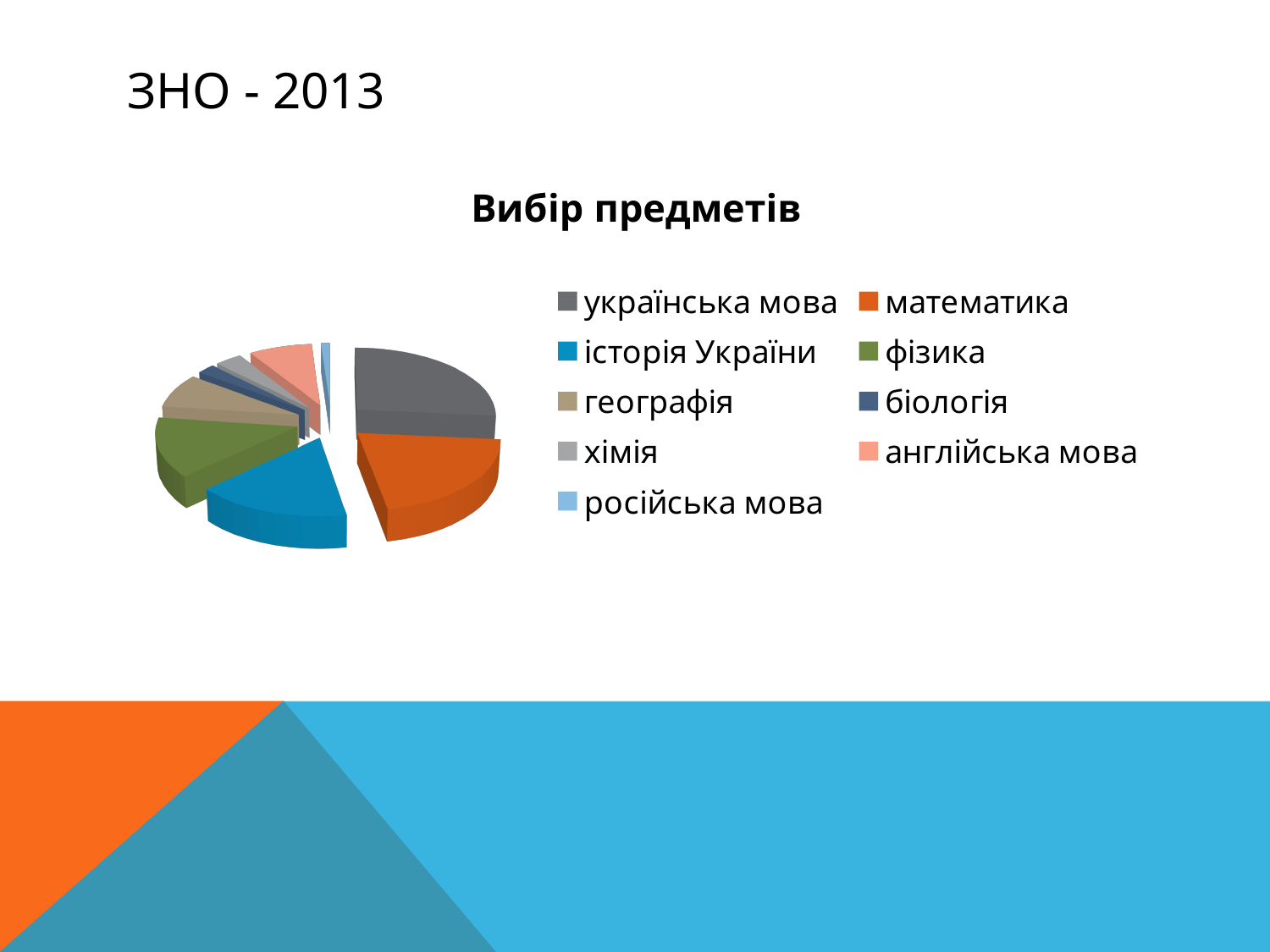
Which category has the smallest slice in the pie chart? російська мова Which slice is larger: історія України or біологія? історія України What is the title of the chart? Вибір предметів What colour is the slice for математика in the pie chart? orange Which slice is larger: українська мова or російська мова? українська мова Which slice is larger: фізика or хімія? фізика How many categories does the pie chart's legend list? 9 What kind of chart is shown on the slide? pie chart